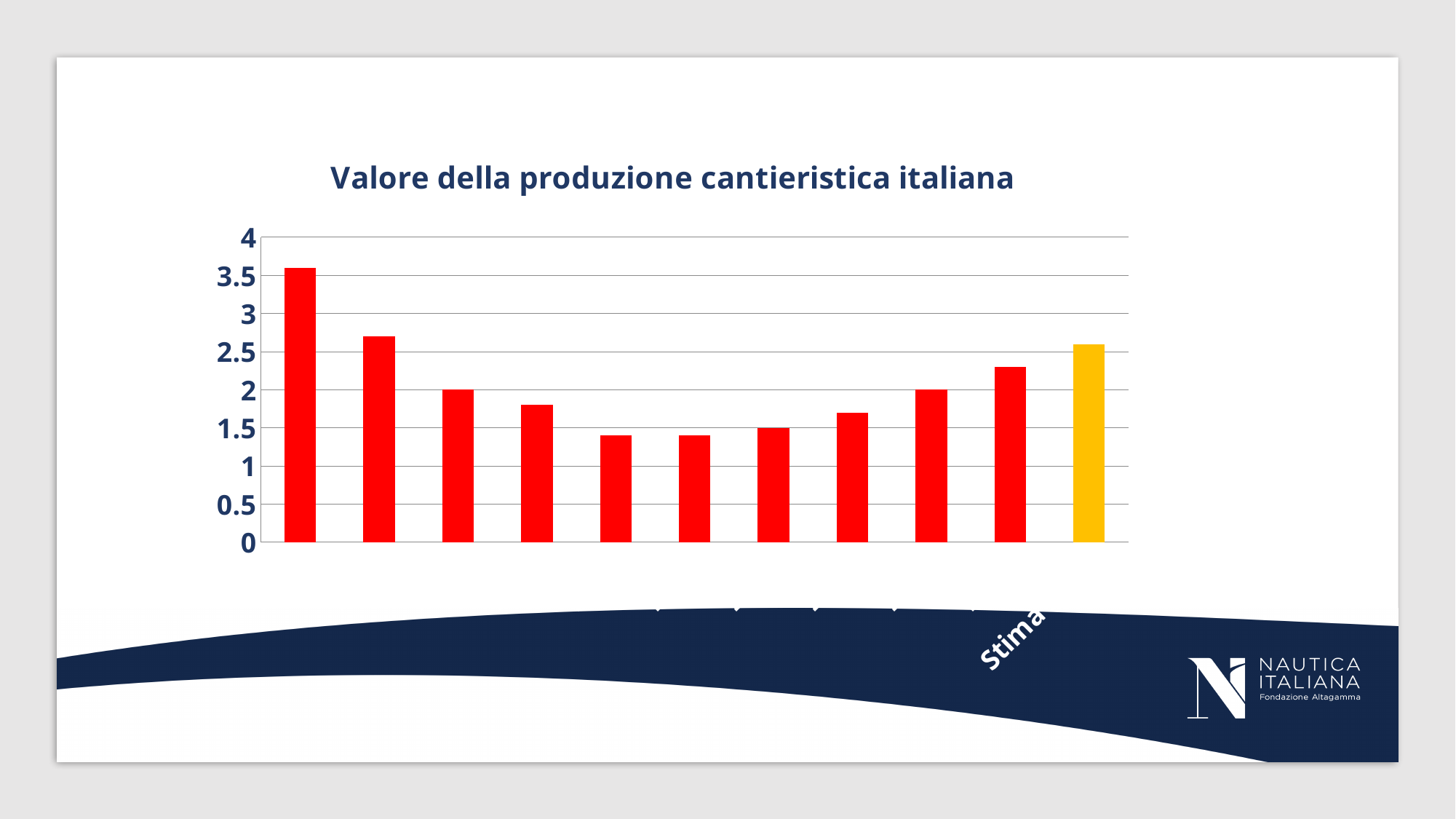
Do the values rise or fall from the first bar to the fifth bar? fall How many bars are plotted in the chart? 11 What is the title of the chart? Valore della produzione cantieristica italiana Which bar is the highest in the chart? the first (leftmost) bar Which is larger, the second bar from the left or the tenth bar from the left? the second bar What is the value of the seventh bar from the left? 1.5 Is the value of the yellow bar labelled 'Stima' greater or less than 3? less What kind of chart is shown on the slide? bar chart Is the value of the fourth bar from the left greater or less than 2? less What is the value of the third bar from the left? 2 What colour is the last bar, labelled 'Stima'? yellow Is the value of the first (leftmost) bar greater or less than 3? greater